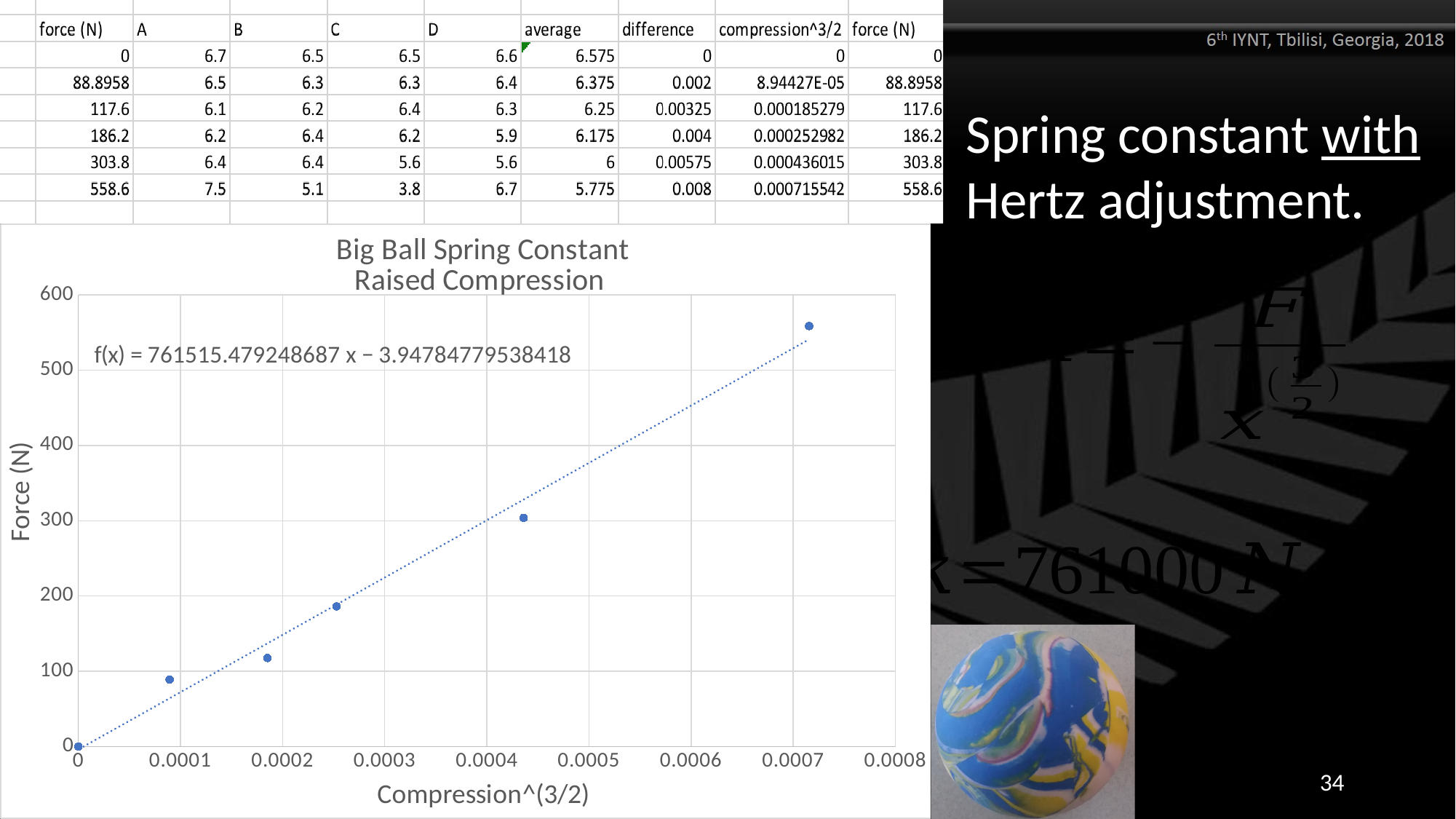
What is the trendline equation printed on the chart? f(x) = 761515.479248687 x − 3.94784779538418 What is the title of the chart? Big Ball Spring Constant Raised Compression What are the x-axis and y-axis labels of the chart? Compression^(3/2) and Force (N) Is the force value of the point near 0.0002 on the x axis greater or less than 200? less Is the force value of the point near 0.0004 on the x axis greater or less than 400? less What kind of chart is shown on the slide? scatter chart Which has the higher force: the point near 0.0004 or the point near 0.00025 on the x axis? the point near 0.0004 Do the plotted force values rise or fall as Compression^(3/2) increases? rise Is the force value of the point near 0.00025 on the x axis greater or less than 100? greater How many data points are plotted in the Big Ball Spring Constant chart? 6